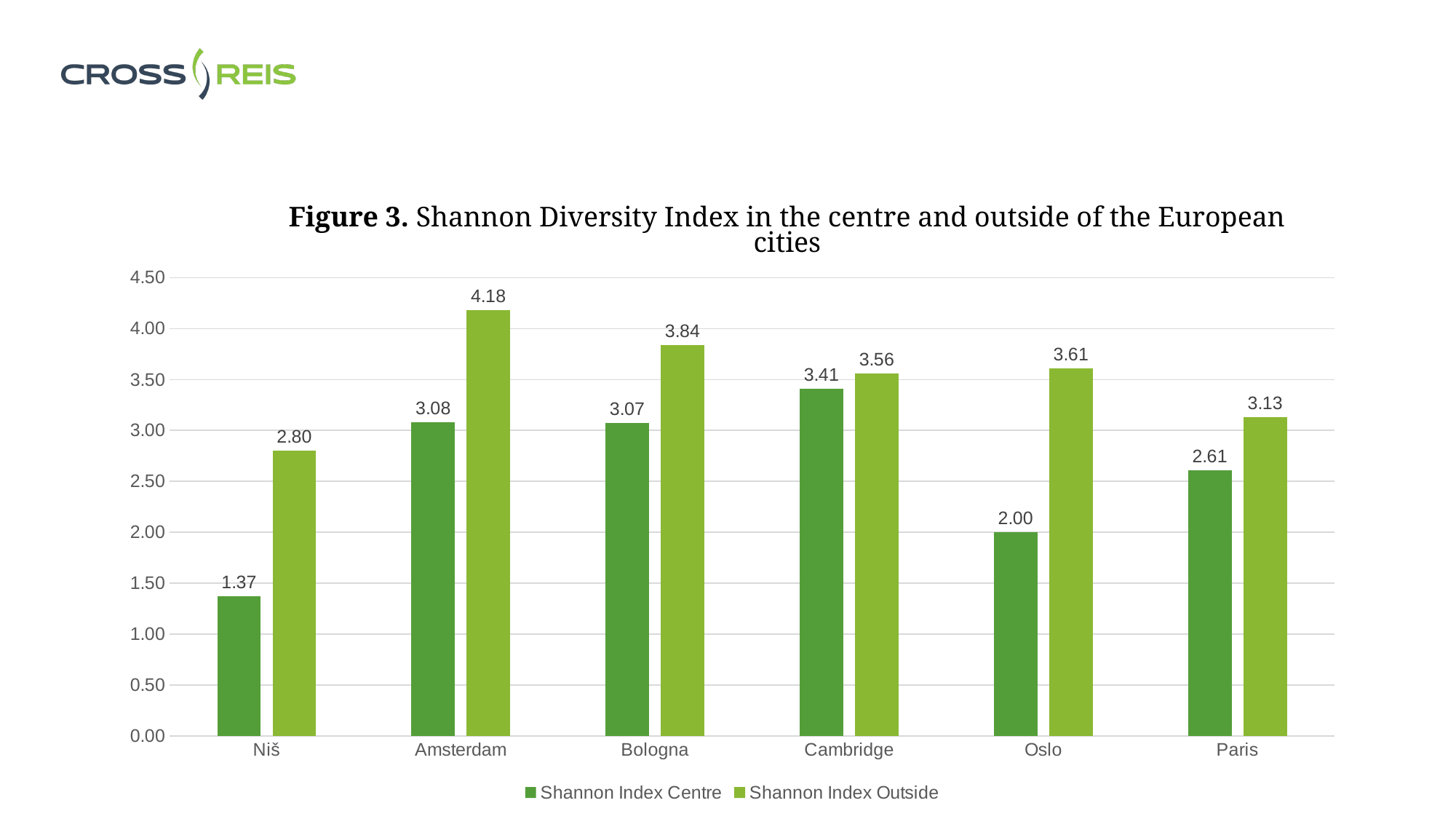
Which is larger for Cambridge: the Shannon Index Centre or the Shannon Index Outside value? Shannon Index Outside How many series does the legend list? 2 How many cities are shown on the x axis? 6 Which city has the highest Shannon Index Outside value? Amsterdam What is the figure number given in the chart title? Figure 3 Is the Shannon Index Outside value for Bologna greater or less than 3.50? greater What kind of chart is shown on the slide? Bar chart What is the Shannon Index Centre value for Oslo? 2.00 Which city has the lowest Shannon Index Centre value? Niš What is the difference between the Shannon Index Outside and Shannon Index Centre values for Oslo? 1.61 What is the Shannon Index Outside value for Amsterdam? 4.18 What is the Shannon Index Centre value for Niš? 1.37